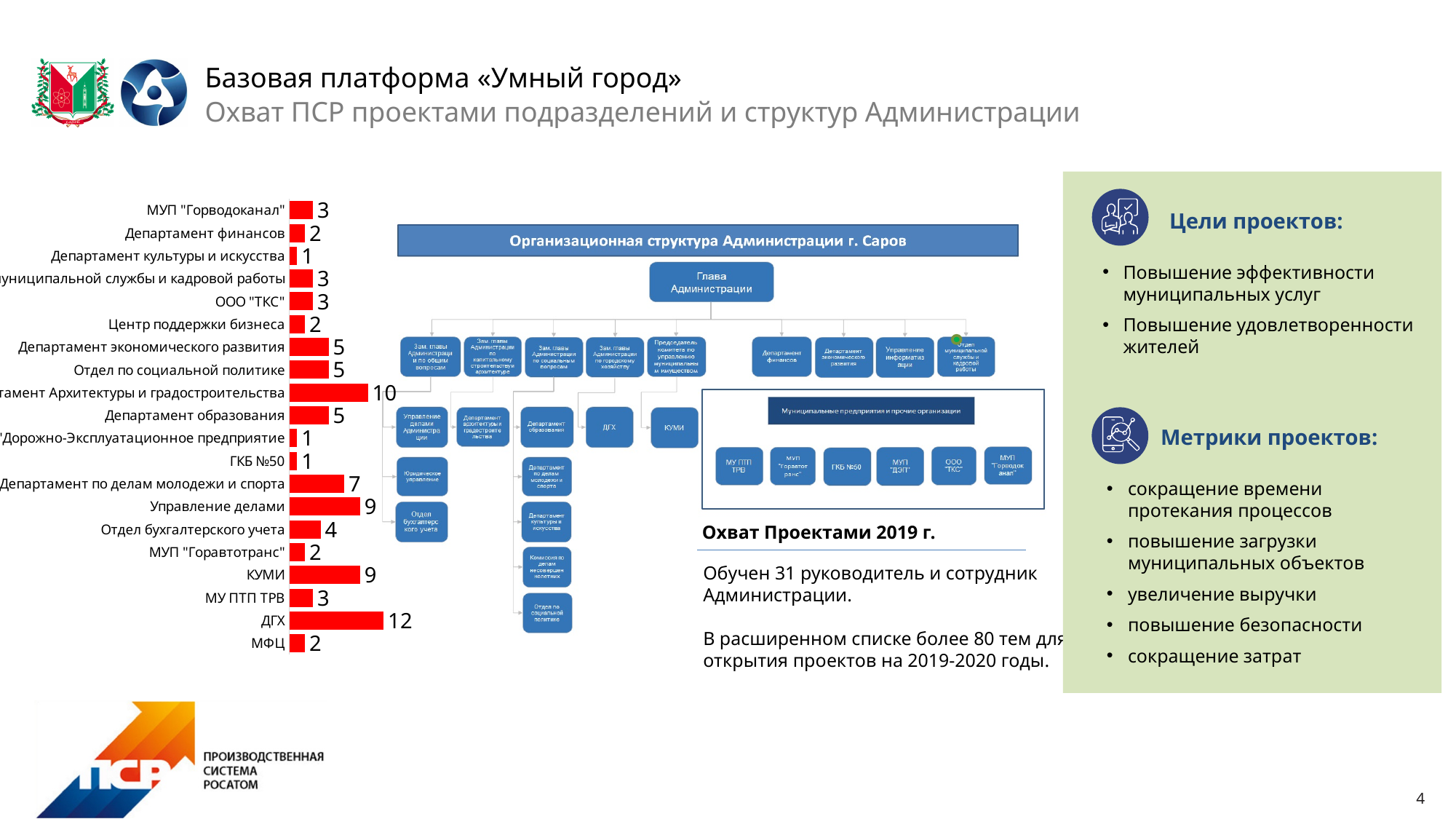
What type of chart is shown on the left of the slide? bar chart What is the difference between the values for ДГХ and Управление делами in the bar chart? 3 What is the value for ДГХ in the bar chart? 12 What is the value for Отдел бухгалтерского учета in the bar chart? 4 What is the value for КУМИ in the bar chart? 9 How many categories are shown in the bar chart? 20 What is the value for Департамент по делам молодежи и спорта in the bar chart? 7 What colour are the bars in the bar chart? red What is the value for МФЦ in the bar chart? 2 Which has a larger value in the bar chart, МУП "Горводоканал" or Департамент финансов? МУП "Горводоканал" Which has a larger value in the bar chart, Департамент образования or Департамент по делам молодежи и спорта? Департамент по делам молодежи и спорта Which category has the highest value in the bar chart? ДГХ